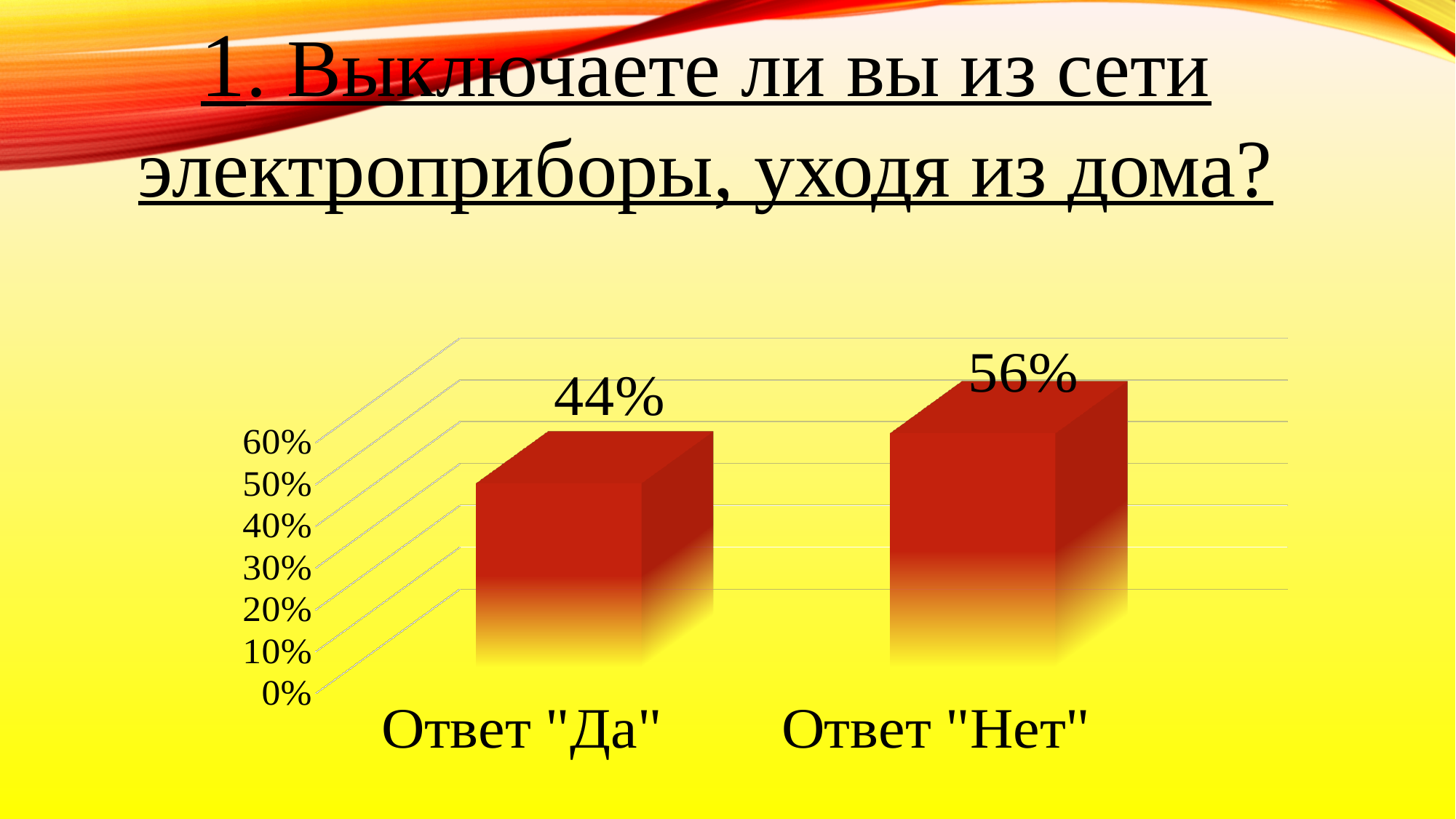
What is the value for Ответ "Да"? 44% What is the value for Ответ "Нет"? 56% What kind of chart is shown on the slide? bar chart What is the difference between the values for Ответ "Нет" and Ответ "Да"? 12% Which category has the lowest value? Ответ "Да" What is the highest value shown on the vertical axis? 60% Is the value for Ответ "Нет" greater or less than 50%? greater Which is larger, the value for Ответ "Да" or the value for Ответ "Нет"? Ответ "Нет" Which category has the highest value? Ответ "Нет" What colour are the bars in the chart? red Is the value for Ответ "Да" greater or less than 50%? less How many categories are shown in the chart? 2